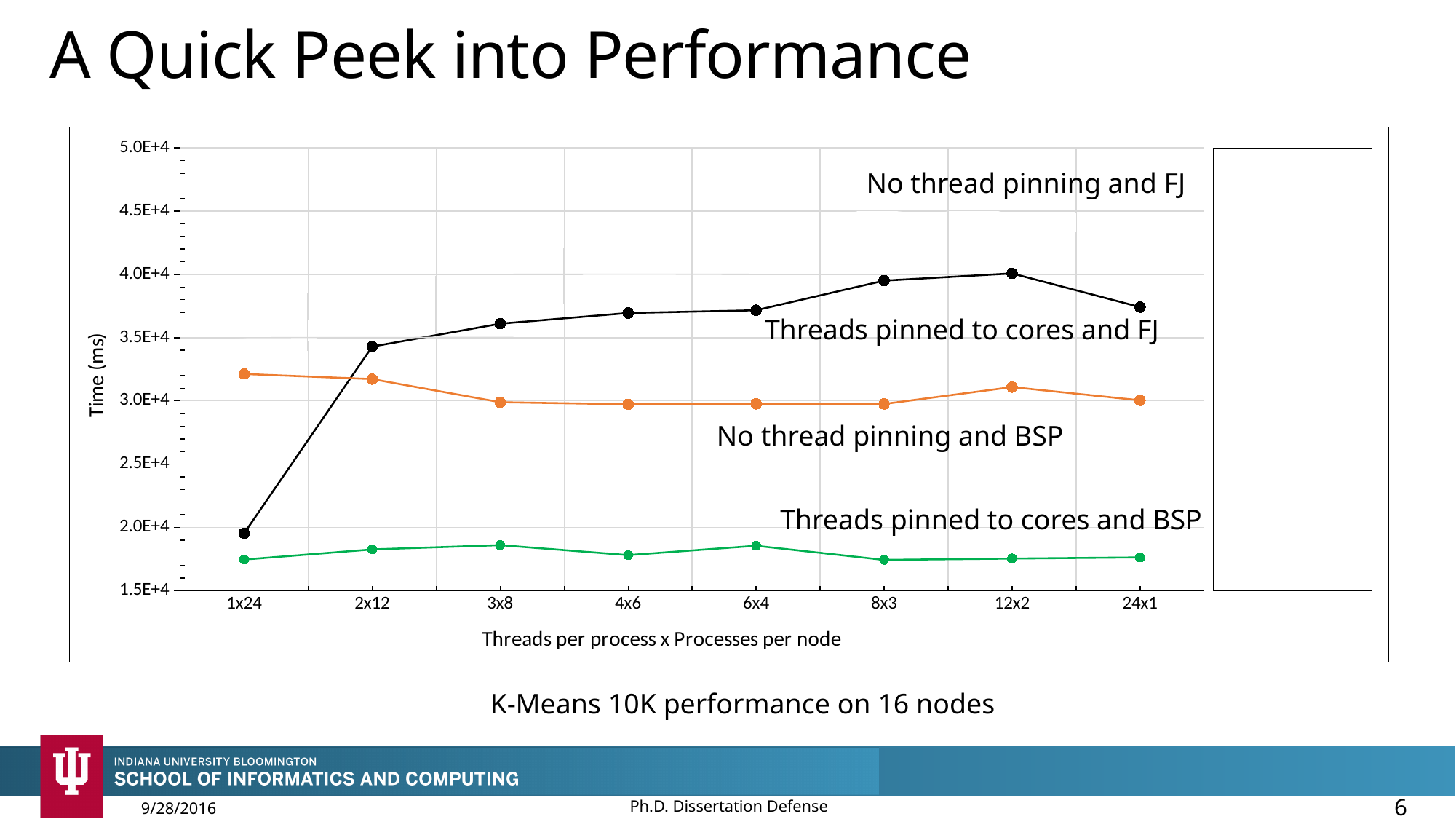
How many lines are plotted on the chart? 3 How many thread-per-process x processes-per-node configurations are shown on the x axis? 8 Is the value of the green line at 3x8 greater or less than 2.0E+4? less At 2x12, which line has the larger value, the black line or the orange line? black line What kind of chart is shown on the slide? line chart At 1x24, which line has the larger value, the black line or the orange line? orange line Which line has the lowest values across all configurations? green line Is the value of the orange line at 1x24 greater or less than 3.0E+4? greater What is the title of the x axis? Threads per process x Processes per node Is the value of the black line at 3x8 greater or less than 3.5E+4? greater At which configuration does the black line reach its lowest value? 1x24 Does the black line rise or fall from 1x24 to 12x2? rise